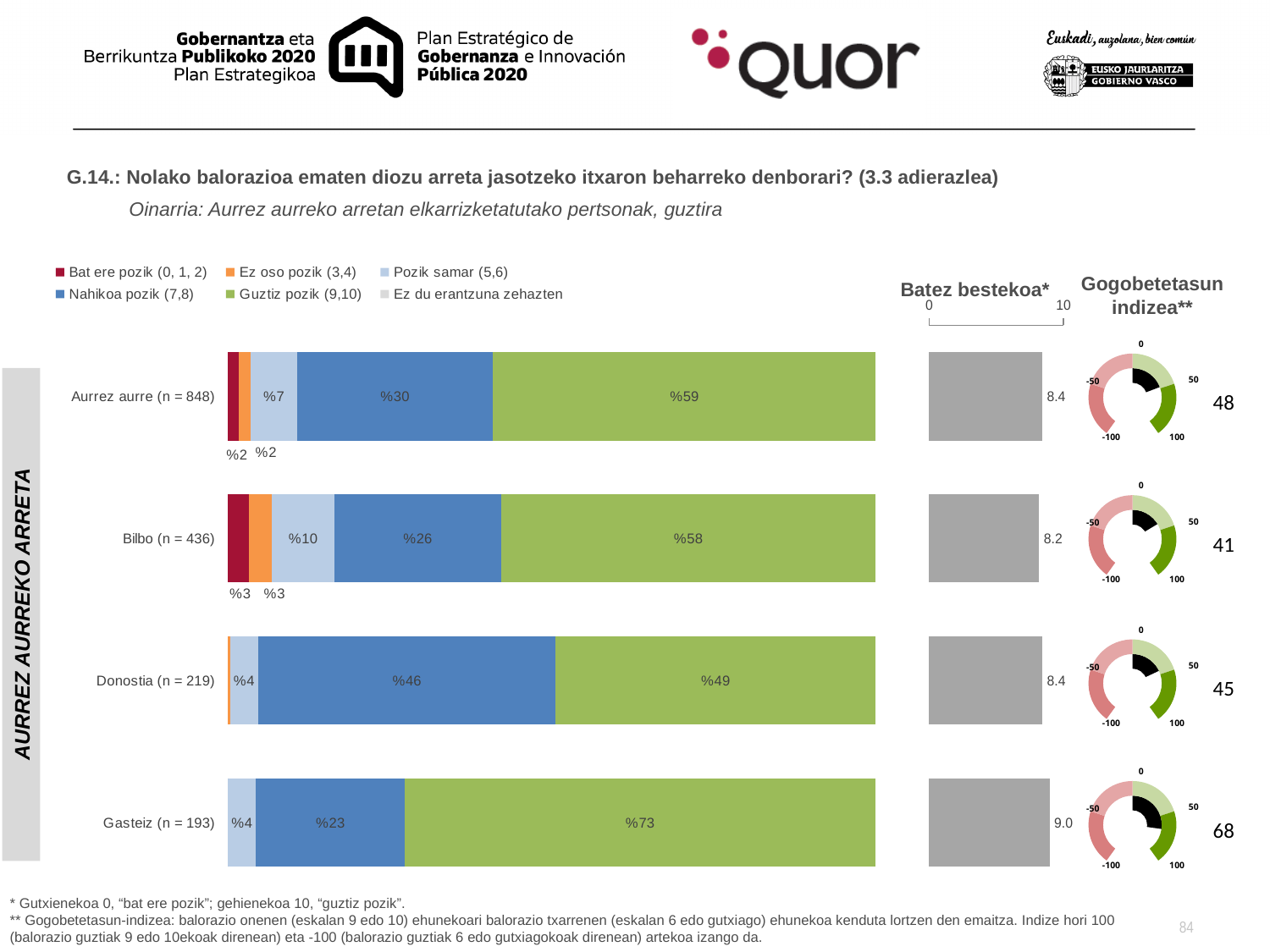
In the stacked bar chart, what is the 'Pozik samar (5,6)' value for Bilbo (n = 436)? %10 In the stacked bar chart, what is the 'Nahikoa pozik (7,8)' value for Donostia (n = 219)? %46 In the stacked bar chart, which category has the highest 'Guztiz pozik (9,10)' value? Gasteiz (n = 193) In the 'Gogobetetasun indizea**' gauges, which category has the lowest index value? Bilbo (n = 436) In the 'Gogobetetasun indizea**' gauges, what is the index value for Bilbo (n = 436)? 41 How many series does the legend of the stacked bar chart list? 6 What kind of chart is used to show the satisfaction distribution by category on the left of the slide? Stacked bar chart In the stacked bar chart, which is larger for Aurrez aurre (n = 848): 'Nahikoa pozik (7,8)' or 'Guztiz pozik (9,10)'? Guztiz pozik (9,10) In the 'Batez bestekoa*' chart, what is the average value for Gasteiz (n = 193)? 9.0 How many categories (rows) does the stacked bar chart show? 4 In the stacked bar chart, what is the 'Guztiz pozik (9,10)' value for Gasteiz (n = 193)? %73 In the stacked bar chart, what is the difference between the 'Guztiz pozik (9,10)' values for Gasteiz (n = 193) and Bilbo (n = 436)? 15 percentage points